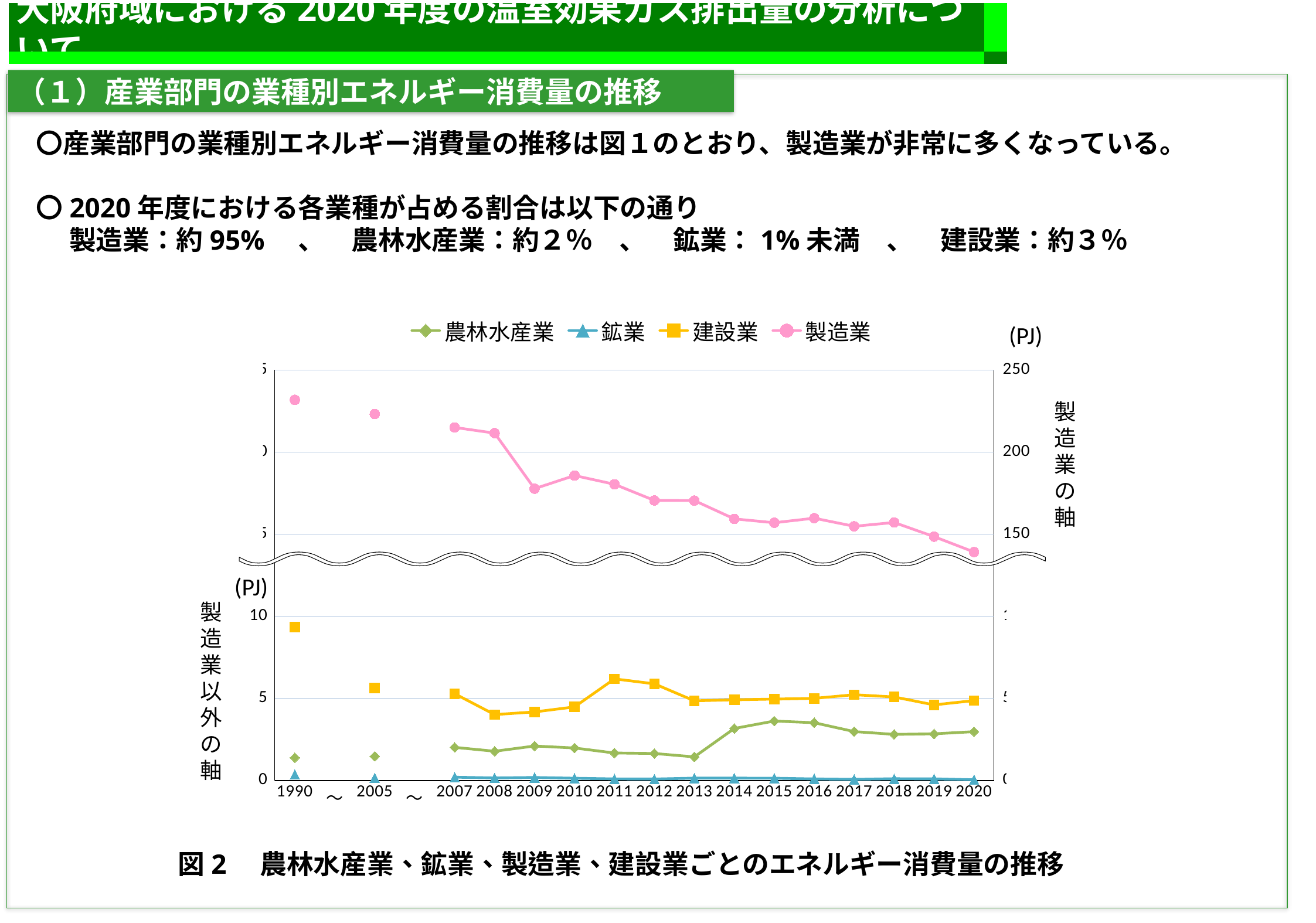
How many series does the legend of the chart list? 4 In 2020, which is larger, the value for 建設業 or the value for 農林水産業? 建設業 Is the value for 製造業 in 1990 greater or less than 200? greater Is the value for 製造業 in 2020 greater or less than 150? less Is the value for 建設業 in 1990 greater or less than 5? greater In which year is the value for 製造業 lowest? 2020 What kind of chart is shown in 図2? line chart Which series is plotted against the right-hand axis labelled 製造業の軸? 製造業 Does the value for 製造業 rise or fall from 1990 to 2020? fall In which year is the value for 製造業 highest? 1990 How many years are labelled on the x axis of the chart? 16 In which year is the value for 建設業 highest? 1990